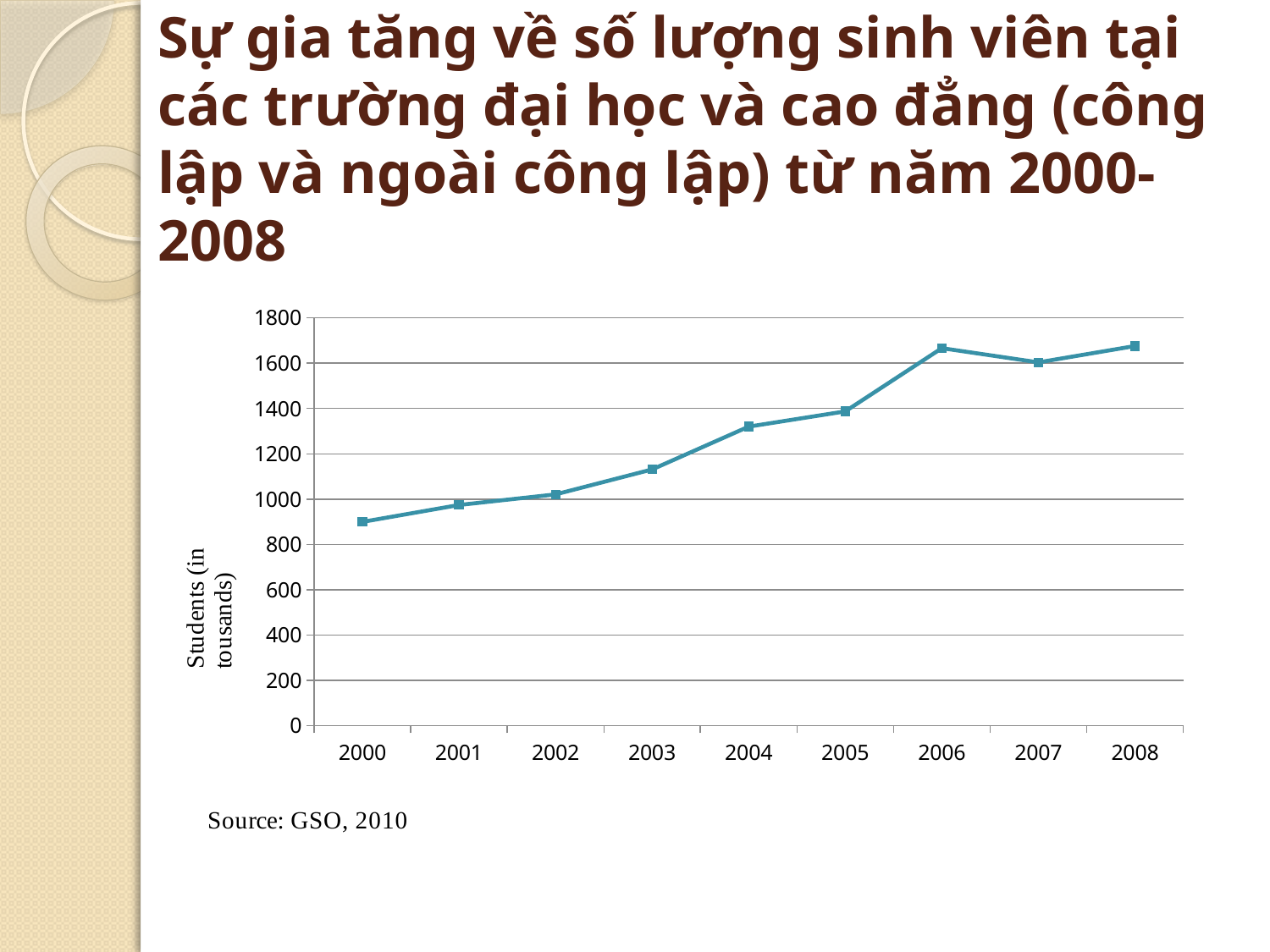
Is the value for 2004 greater or less than 1200? greater Which year has the larger value, 2006 or 2007? 2006 Do the values generally rise or fall from 2000 to 2008? rise Is the value for 2006 greater or less than 1600? greater Which year has the larger value, 2002 or 2004? 2004 Is the value for 2003 greater or less than 1200? less What kind of chart is shown on the slide? line chart What is the label on the vertical axis of the chart? Students (in tousands) How many years are plotted on the x axis of the chart? 9 Which year has the lowest number of students in the chart? 2000